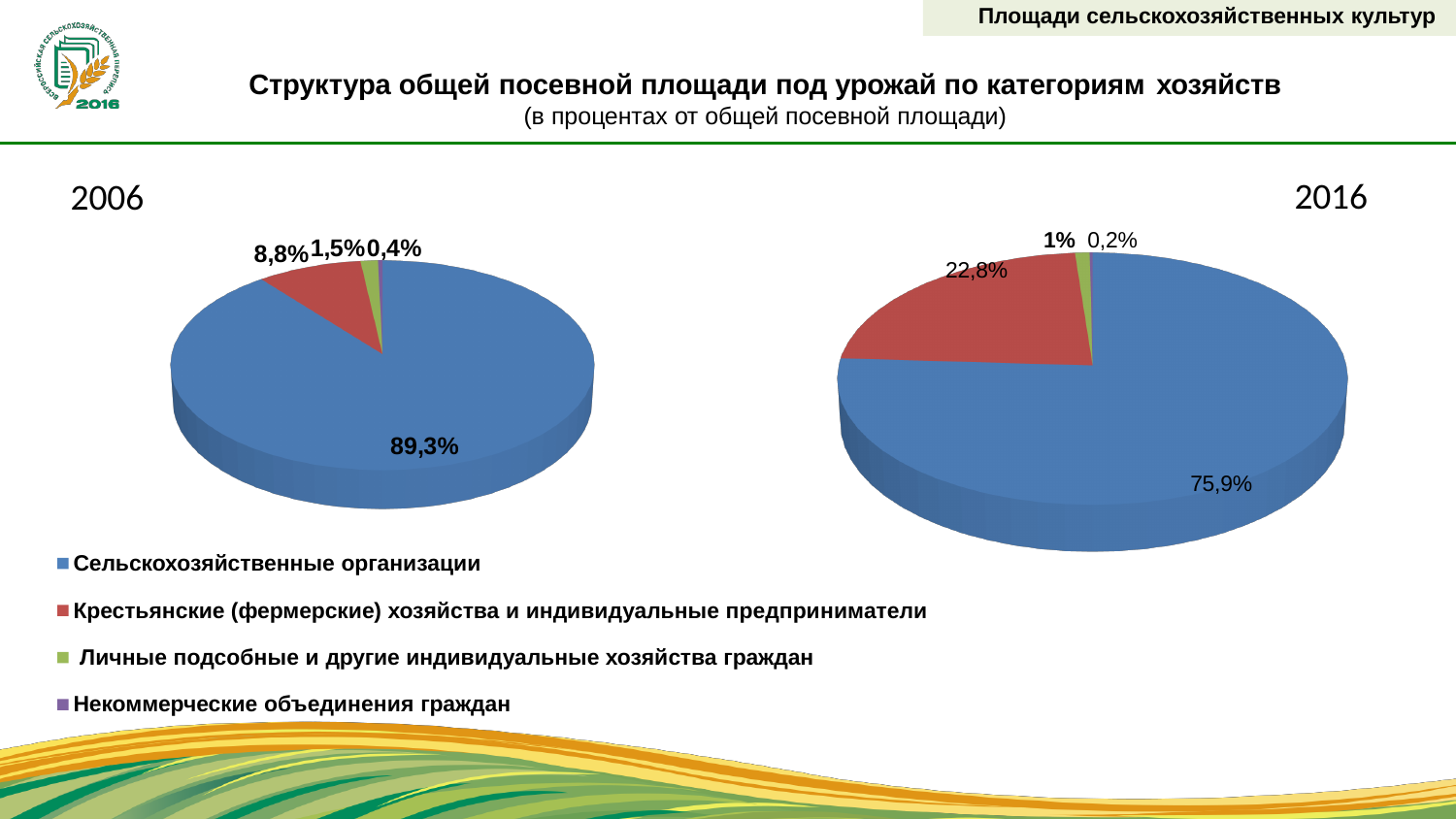
Which colour represents Крестьянские (фермерские) хозяйства и индивидуальные предприниматели in the pie charts? Red Which is larger: the share of Крестьянские (фермерские) хозяйства и индивидуальные предприниматели in 2006 or in 2016? 2016 In the 2006 pie chart, what share is shown for Сельскохозяйственные организации? 89,3% In the 2016 pie chart, what share is shown for Личные подсобные и другие индивидуальные хозяйства граждан? 1% How many categories does the legend list for the pie charts? 4 What type of chart is used for the 2006 and 2016 data? Pie chart In the 2006 pie chart, what share is shown for Личные подсобные и другие индивидуальные хозяйства граждан? 1,5% In the 2006 pie chart, which category has the smallest share? Некоммерческие объединения граждан In the 2016 pie chart, what share is shown for Некоммерческие объединения граждан? 0,2% In the 2016 pie chart, which category has the largest share? Сельскохозяйственные организации In the 2016 pie chart, what share is shown for Крестьянские (фермерские) хозяйства и индивидуальные предприниматели? 22,8% What is the difference between the share of Сельскохозяйственные организации in 2006 and in 2016? 13,4 percentage points